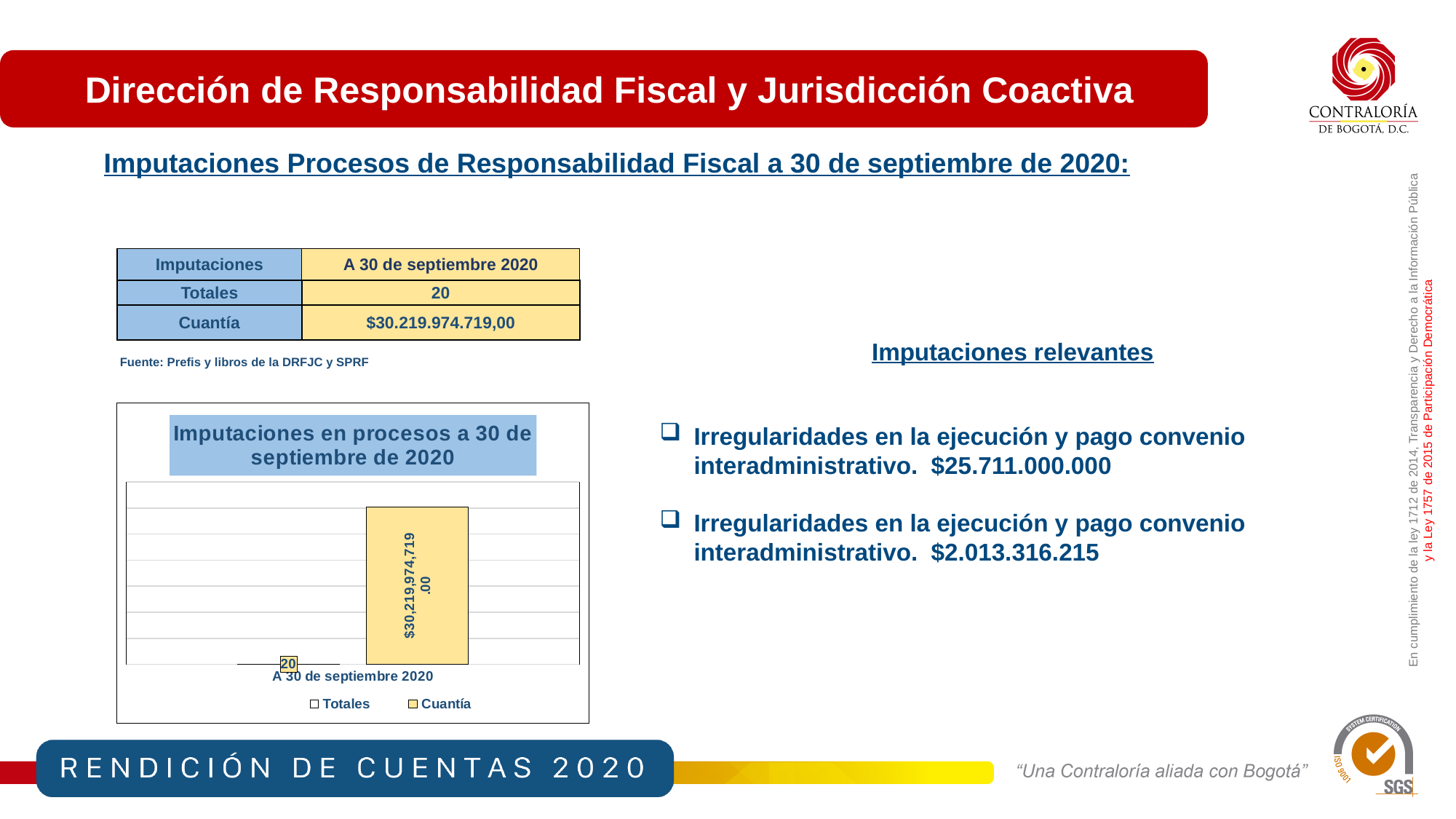
Which series has the taller bar in the chart, Totales or Cuantía? Cuantía Which series has the highest value in the chart? Cuantía What kind of chart is shown on the slide? Bar chart What is the value of the Totales bar in the chart? 20 How many categories are shown on the x axis of the chart? 1 What is the value of the Cuantía bar in the chart? $30,219,974,719.00 How many series does the chart's legend list? 2 What is the title of the chart on the slide? Imputaciones en procesos a 30 de septiembre de 2020 Which series are listed in the chart's legend? Totales and Cuantía Which series has the lowest value in the chart? Totales What is the category label on the x axis of the chart? A 30 de septiembre 2020